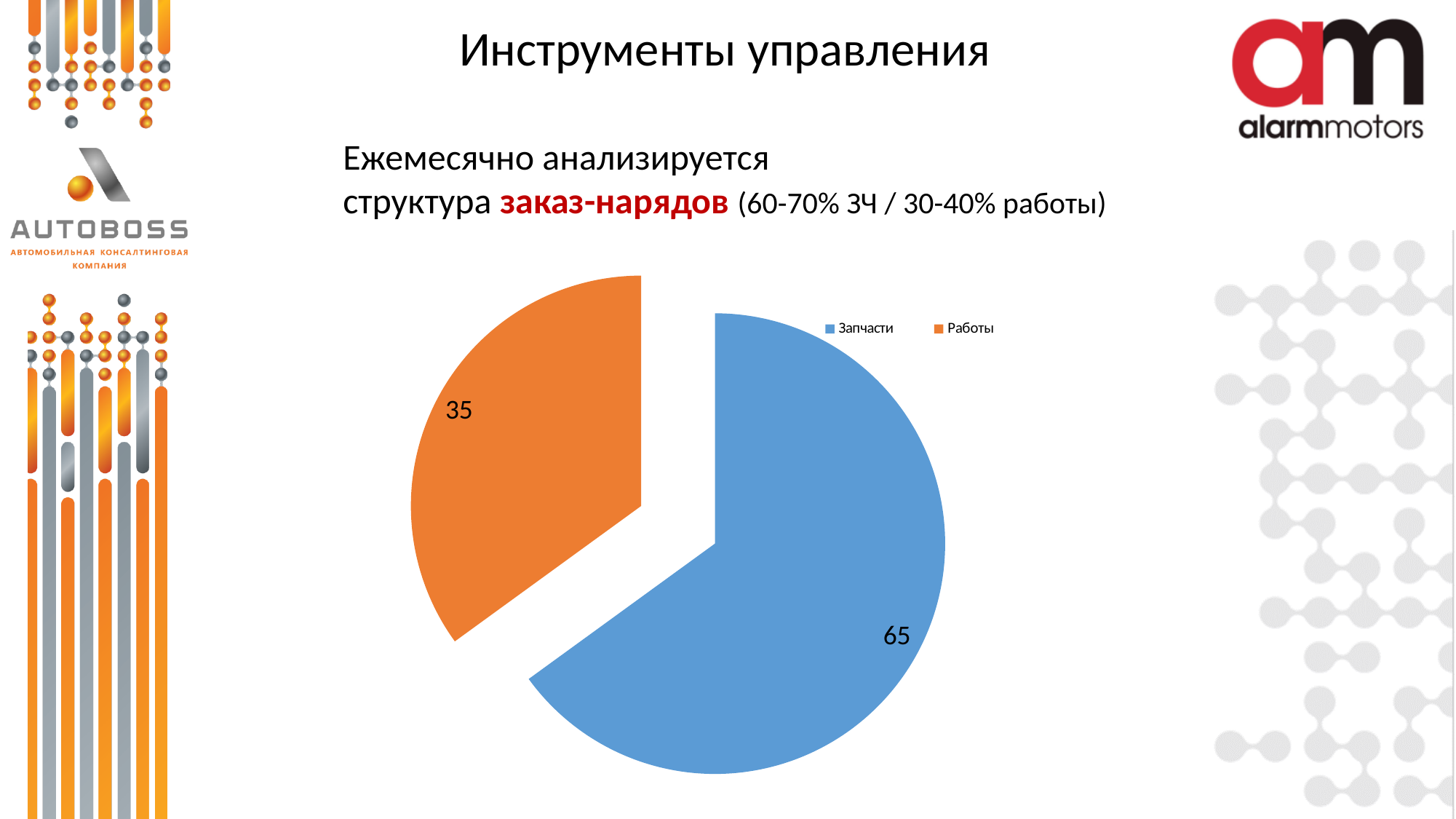
Which is larger, Запчасти or Работы? Запчасти What is the value for Работы in the pie chart? 35 What share of the pie does the Работы slice represent? 35% What is the difference between the values for Запчасти and Работы? 30 How many entries does the legend list? 2 What colour is the Работы slice in the pie chart? orange Which slice of the pie chart is the smallest? Работы How many slices does the pie chart have? 2 Which slice of the pie chart is the largest? Запчасти What kind of chart is shown on the slide? pie chart What colour is the Запчасти slice in the pie chart? blue What is the value for Запчасти in the pie chart? 65